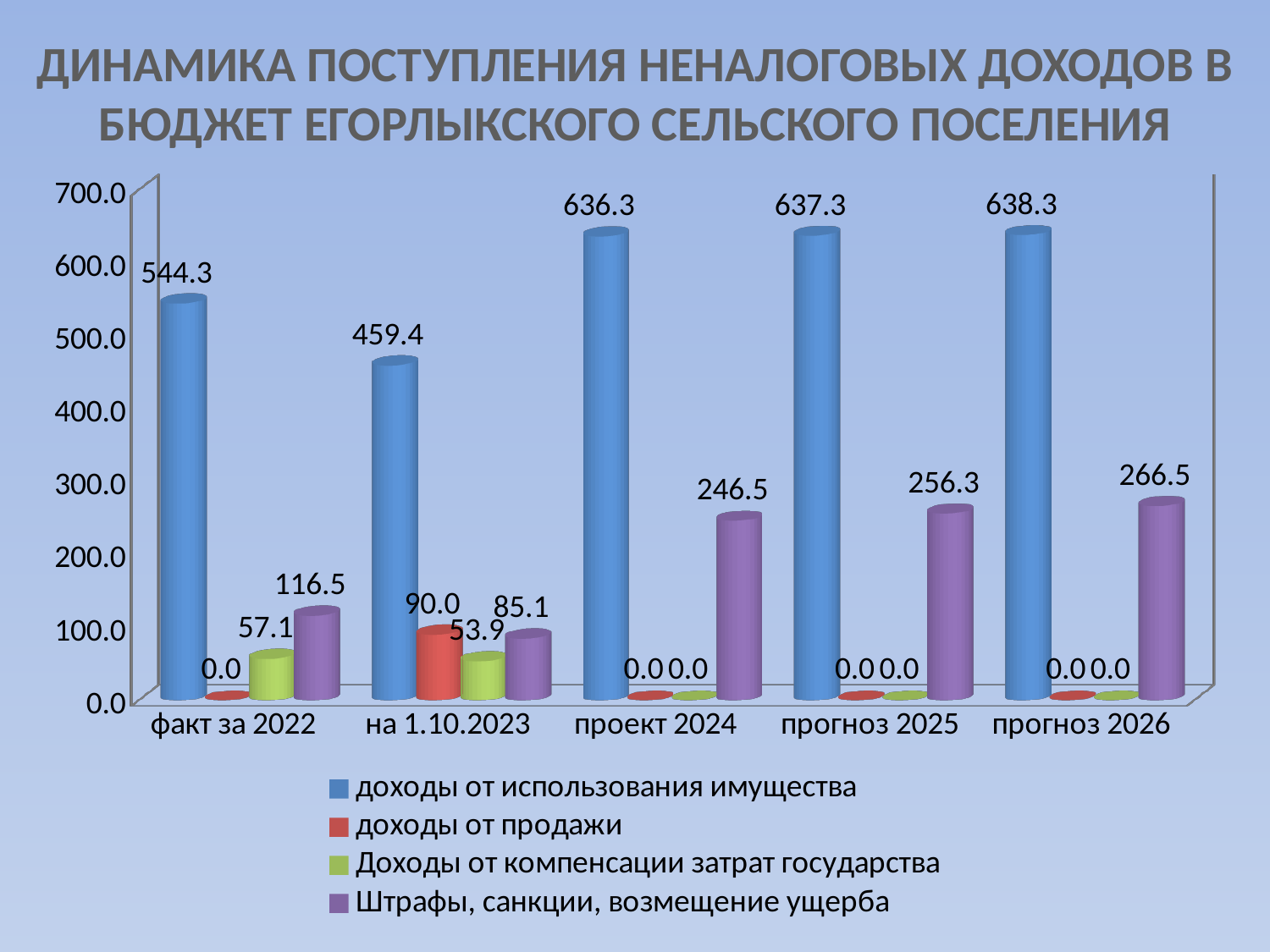
What kind of chart is shown on the slide? bar chart Which category has the highest value for «доходы от использования имущества»? прогноз 2026 What is the value of «доходы от использования имущества» for «факт за 2022»? 544.3 Do the values of «Штрафы, санкции, возмещение ущерба» rise or fall from «проект 2024» to «прогноз 2026»? rise How many categories are shown on the x axis? 5 What is the value of «Доходы от компенсации затрат государства» for «факт за 2022»? 57.1 Which category has the lowest value for «доходы от использования имущества»? на 1.10.2023 What is the value of «доходы от продажи» for «на 1.10.2023»? 90.0 How many series does the legend list? 4 Which is larger: «Штрафы, санкции, возмещение ущерба» for «факт за 2022» or for «на 1.10.2023»? факт за 2022 What is the value of «Штрафы, санкции, возмещение ущерба» for «проект 2024»? 246.5 What is the difference between «Штрафы, санкции, возмещение ущерба» for «прогноз 2026» and for «прогноз 2025»? 10.2